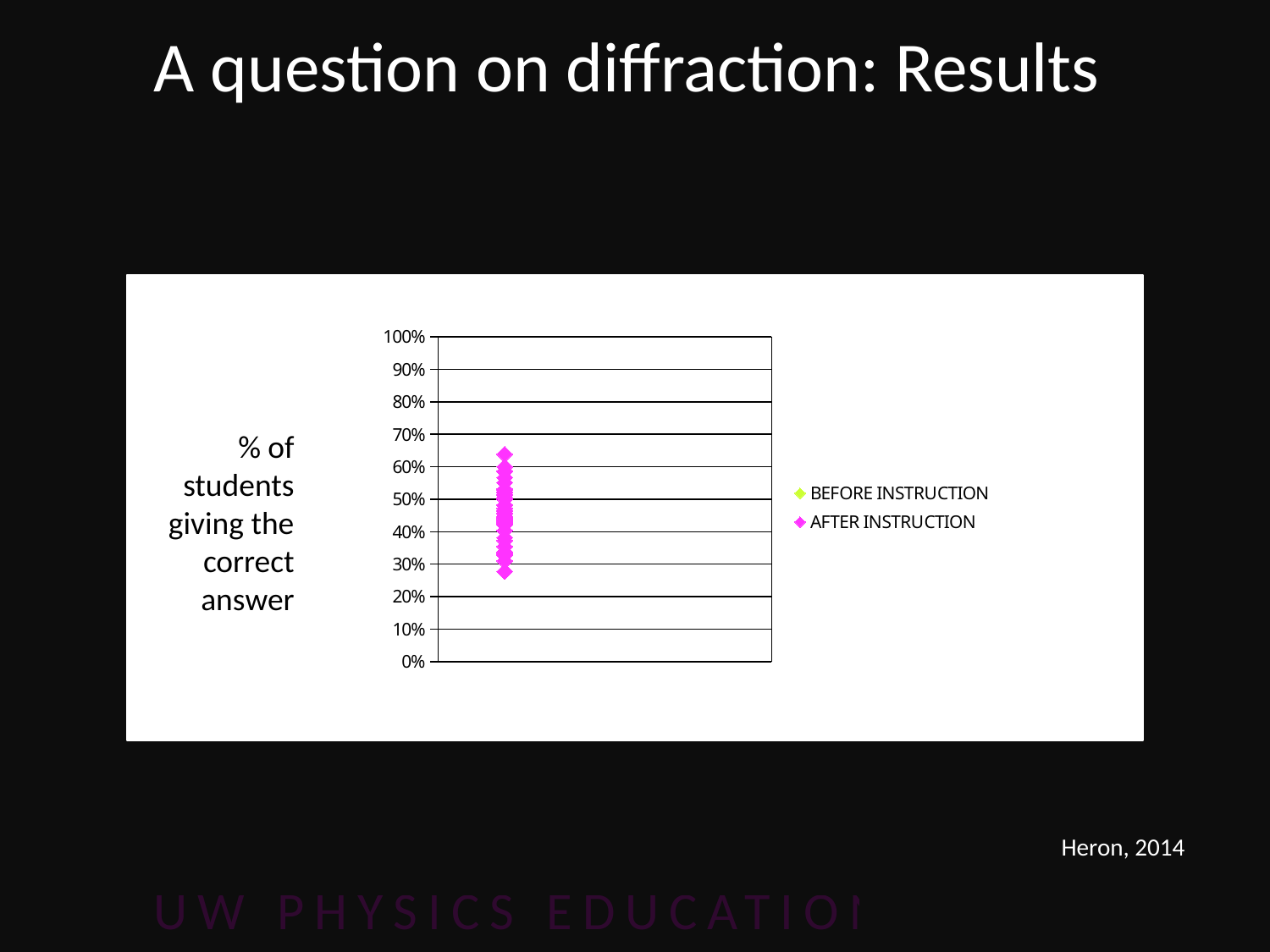
Are all the plotted AFTER INSTRUCTION values greater or less than 70%? less How many series does the chart legend list? 2 Are all the plotted AFTER INSTRUCTION values greater or less than 20%? greater What are the two series names listed in the chart legend? BEFORE INSTRUCTION and AFTER INSTRUCTION What kind of chart is shown on the slide? scatter chart Is the highest plotted AFTER INSTRUCTION value greater or less than 60%? greater What is the maximum value shown on the chart's vertical axis? 100%